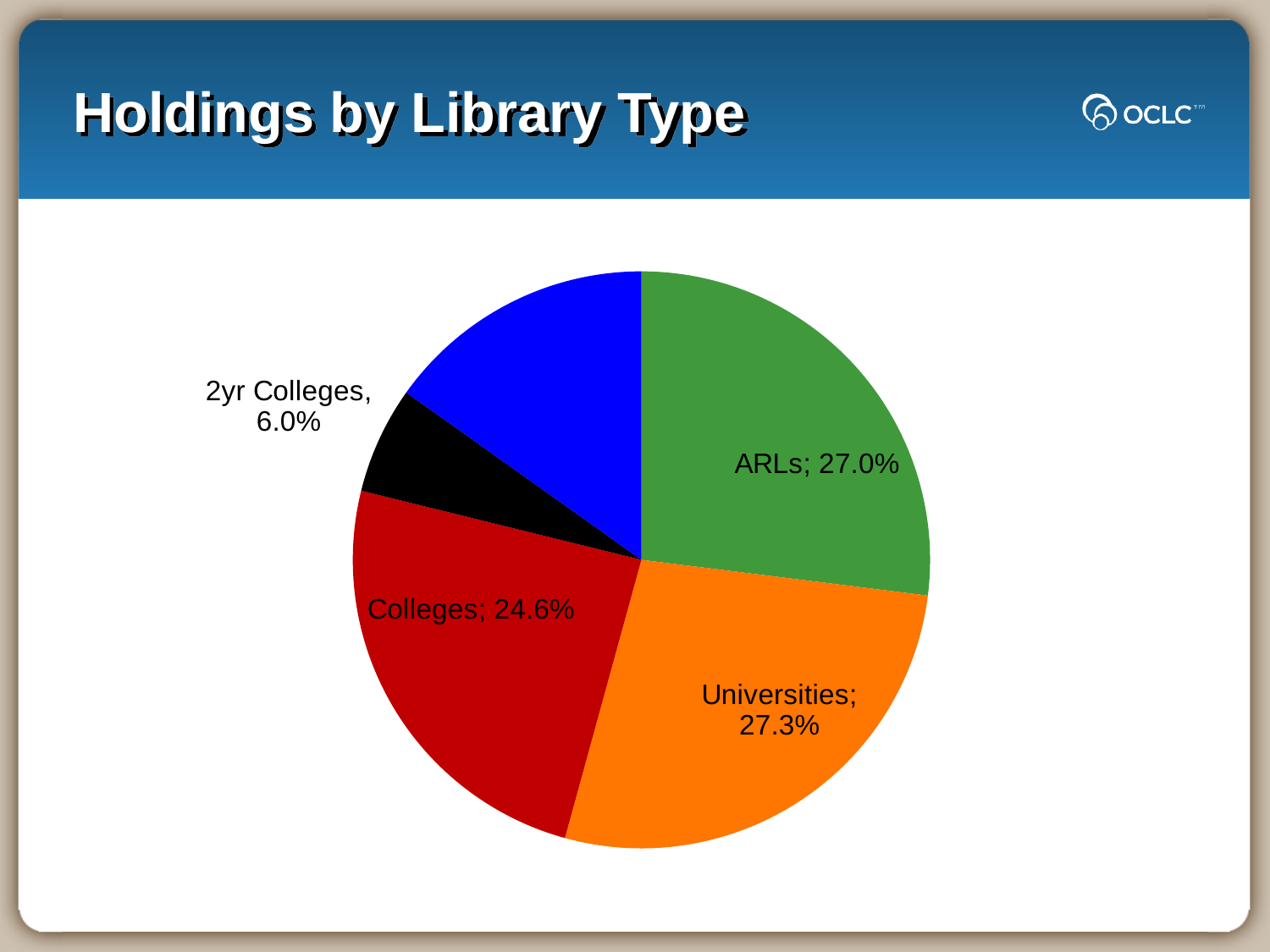
What is the value shown for Colleges? 24.6% Which library type has the smallest share of holdings? 2yr Colleges What share of holdings do 2yr Colleges have? 6.0% Which is larger, the share for Colleges or the share for ARLs? ARLs How many slices does the pie chart have? 5 What is the difference in percentage points between the Universities share and the 2yr Colleges share? 21.3 By how many percentage points does the Universities share exceed the ARLs share? 0.3 What percentage of holdings is attributed to Universities? 27.3% What kind of chart is shown on the slide? Pie chart Which labelled library type has the largest share of holdings? Universities What share of holdings do ARLs account for? 27.0% What colour is the ARLs slice? Green